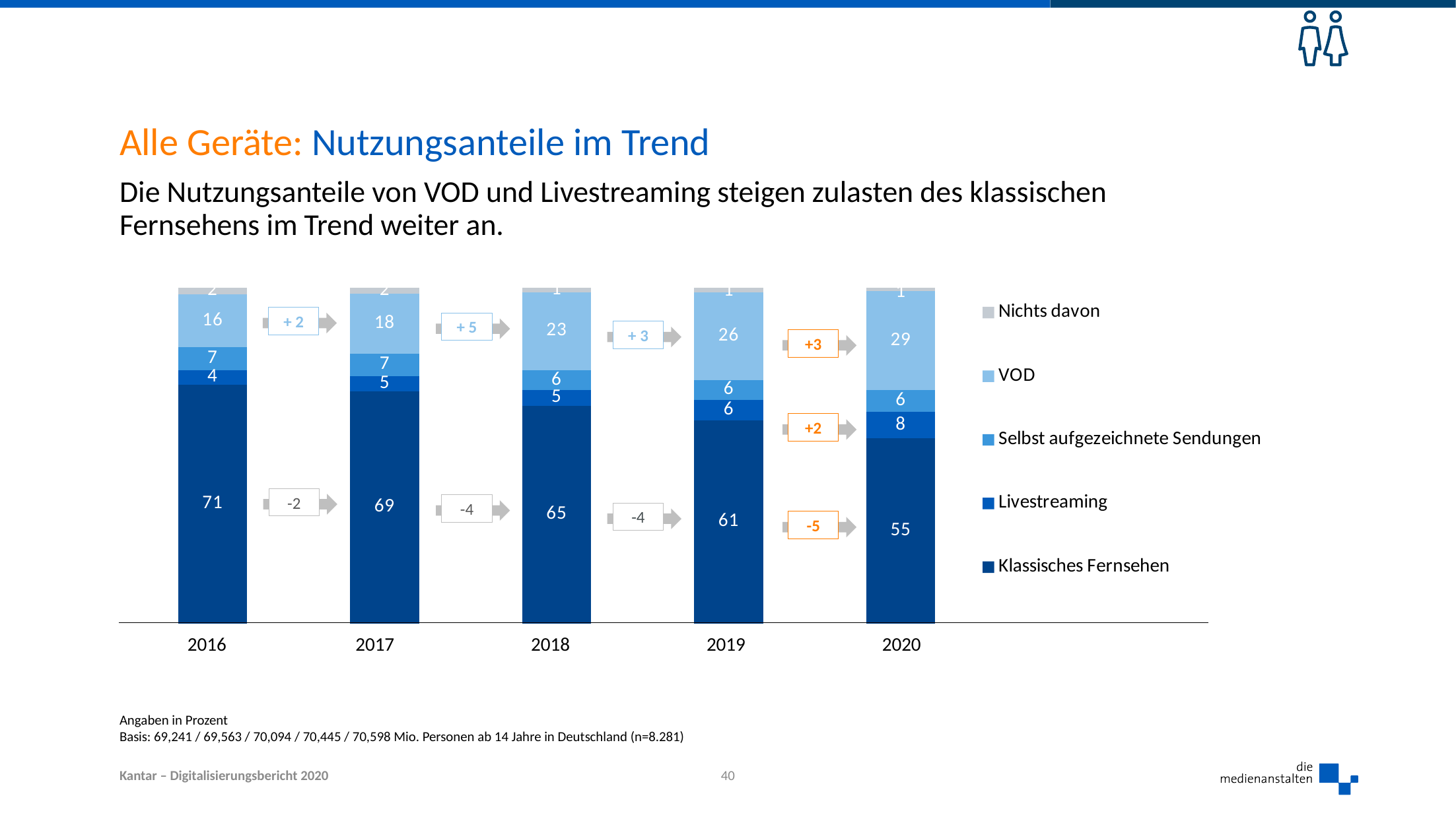
In which year is the value for VOD lowest? 2016 What is the difference between the Klassisches Fernsehen values for 2016 and 2020? 16 What is the value for VOD in 2018? 23 How many series does the legend list? 5 What kind of chart is shown on the slide? Stacked bar chart Does the value for VOD rise or fall from 2016 to 2020? Rises In 2019, which is larger: VOD or Selbst aufgezeichnete Sendungen? VOD In which year is the value for Klassisches Fernsehen highest? 2016 What is the value for Selbst aufgezeichnete Sendungen in 2017? 7 What is the value for Livestreaming in 2016? 4 How many years are shown on the x axis? 5 What is the value for Klassisches Fernsehen in 2020? 55